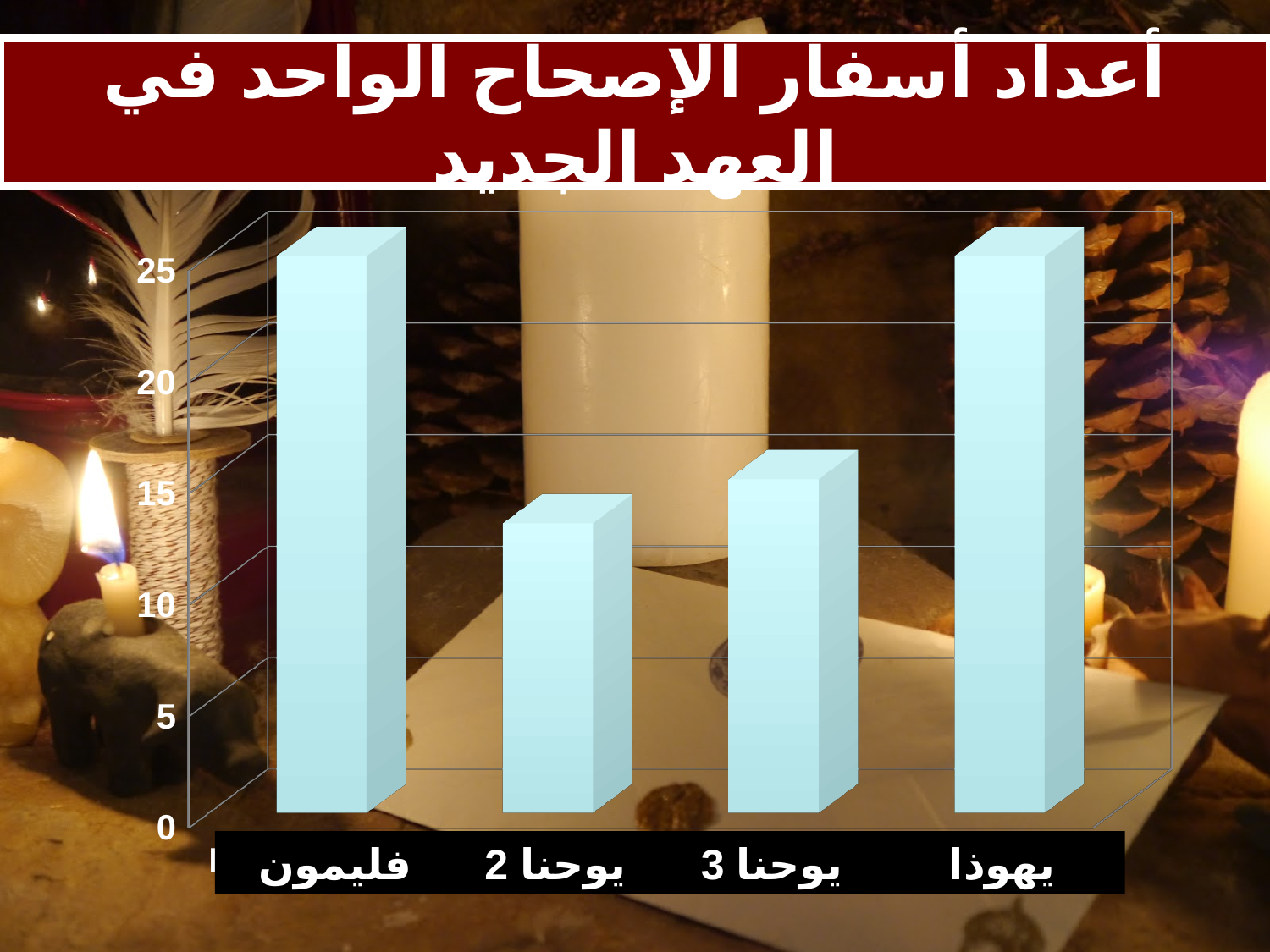
Is the value for يوحنا 2 greater or less than 15? less Is the value for فليمون greater or less than 20? greater Is the value for يوحنا 2 greater or less than 10? greater What kind of chart is shown on the slide? bar chart Which category has the lowest bar in the chart? يوحنا 2 What is the title of the chart on the slide? أعداد أسفار الإصحاح الواحد في العهد الجديد What colour are the bars in the chart? light blue How many categories (books) are shown on the x axis of the chart? 4 Which is larger, the value for يوحنا 2 or the value for يوحنا 3? يوحنا 3